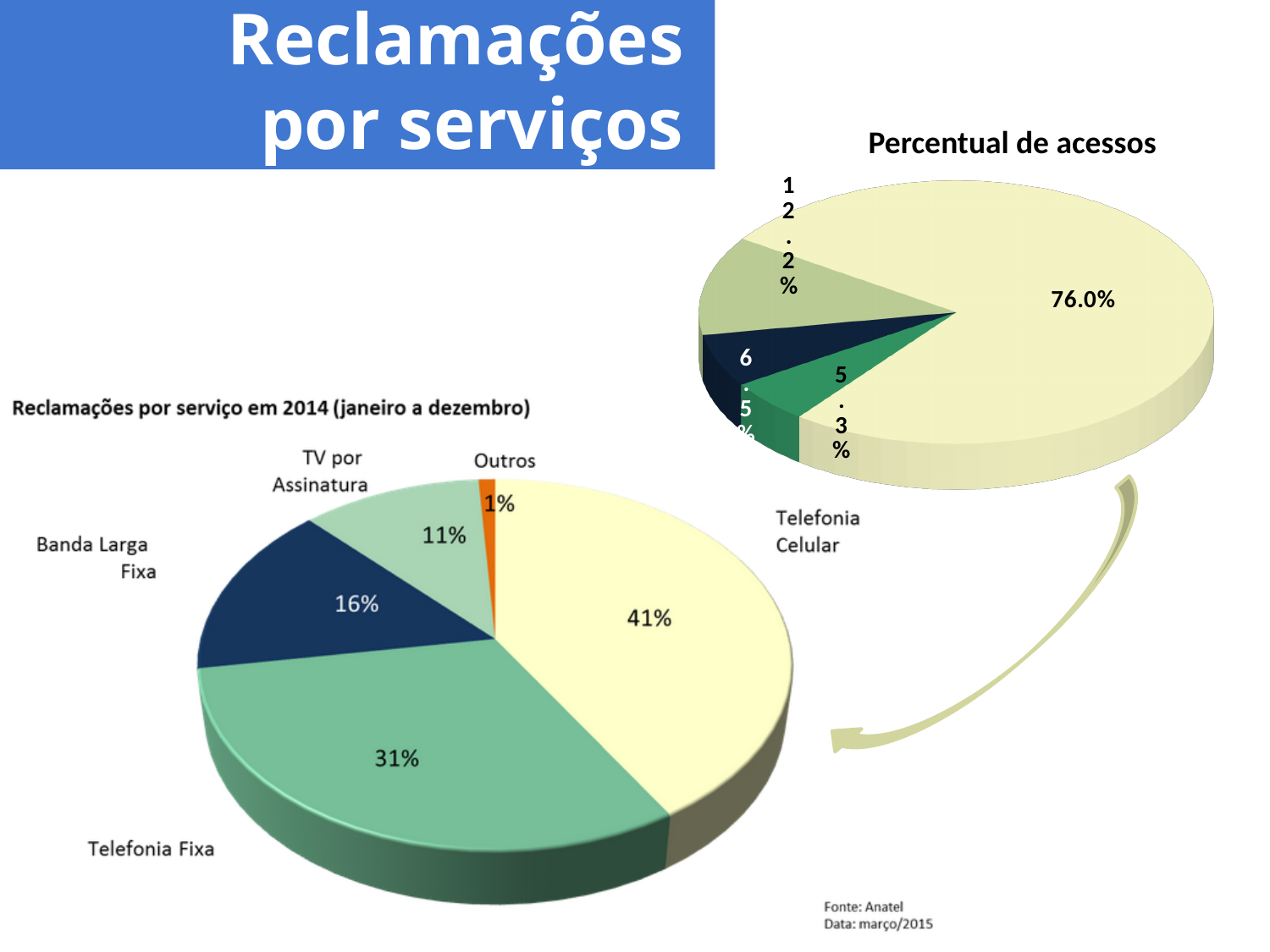
In the 'Percentual de acessos' chart, what is the value of the largest slice? 76.0% How many slices does the 'Percentual de acessos' pie chart have? 4 In the 'Reclamações por serviço em 2014' chart, what is the share for TV por Assinatura? 11% In the 'Reclamações por serviço em 2014' chart, which has a larger share, Banda Larga Fixa or TV por Assinatura? Banda Larga Fixa In the 'Reclamações por serviço em 2014' chart, what is the share for Telefonia Fixa? 31% In the 'Reclamações por serviço em 2014' chart, what is the share for Banda Larga Fixa? 16% How many categories are shown in the 'Reclamações por serviço em 2014' chart? 5 In the 'Reclamações por serviço em 2014' chart, which category has the largest share? Telefonia Celular In the 'Reclamações por serviço em 2014' chart, what is the difference between the shares of Telefonia Celular and Telefonia Fixa? 10% In the 'Reclamações por serviço em 2014' chart, which category has the smallest share? Outros What kind of chart is the 'Reclamações por serviço em 2014 (janeiro a dezembro)' chart? Pie chart In the 'Reclamações por serviço em 2014' chart, what is the share for Telefonia Celular? 41%